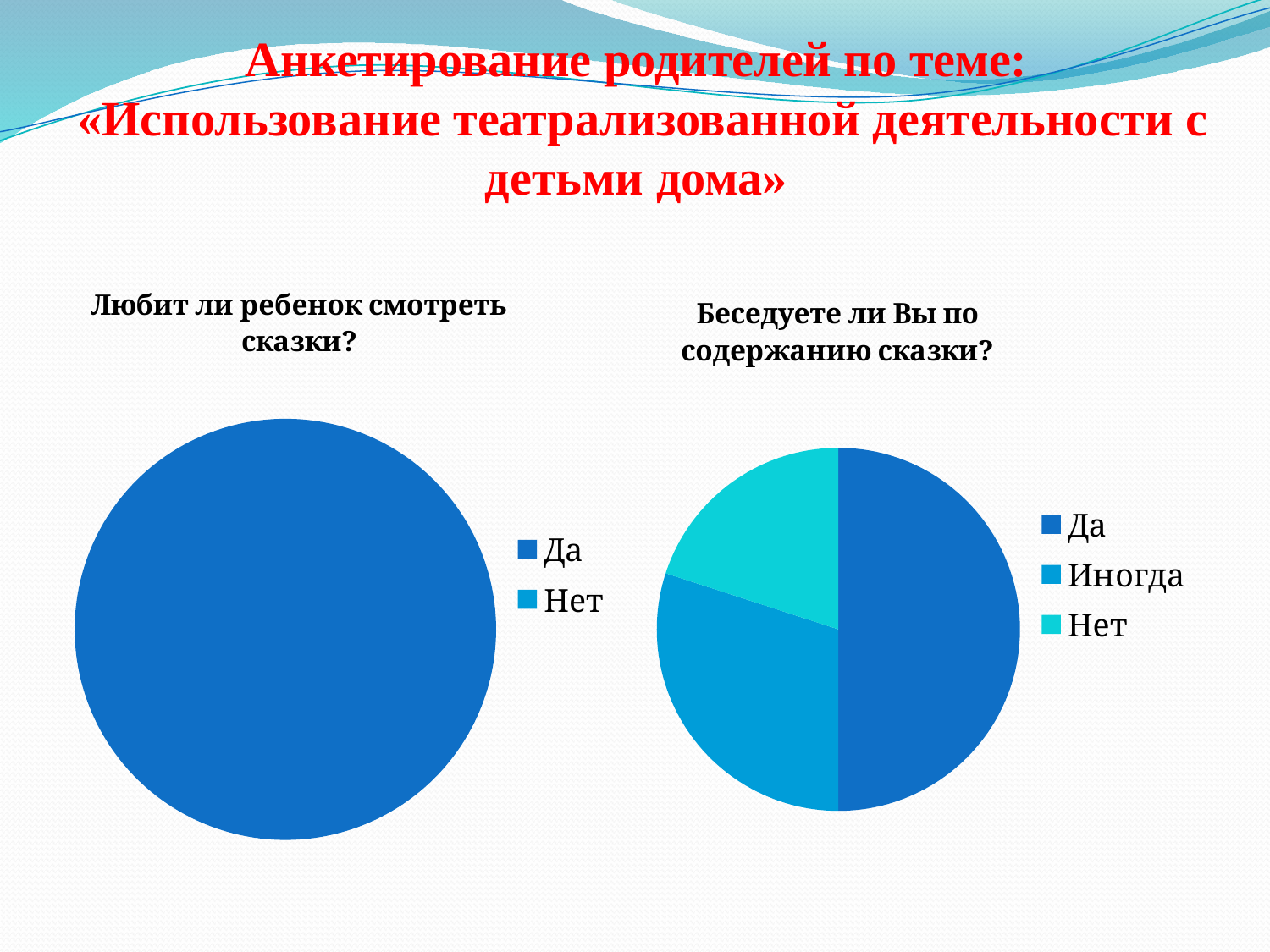
In the left chart «Любит ли ребенок смотреть сказки?», which category has the smallest slice? Нет In the right chart «Беседуете ли Вы по содержанию сказки?», how many entries does the legend list? 3 In the left chart «Любит ли ребенок смотреть сказки?», how many entries does the legend list? 2 In the right chart «Беседуете ли Вы по содержанию сказки?», which slice is larger: Да or Иногда? Да In the right chart «Беседуете ли Вы по содержанию сказки?», which category has the smallest slice? Нет What kind of chart is the right chart titled «Беседуете ли Вы по содержанию сказки?»? Pie chart What kind of chart is the left chart titled «Любит ли ребенок смотреть сказки?»? Pie chart In the right chart «Беседуете ли Вы по содержанию сказки?», which category has the largest slice? Да What is the title of the left pie chart? Любит ли ребенок смотреть сказки? In the right chart «Беседуете ли Вы по содержанию сказки?», which slice is larger: Иногда or Нет? Иногда In the right chart «Беседуете ли Вы по содержанию сказки?», which legend entry is shown in the lightest (cyan) colour? Нет In the left chart «Любит ли ребенок смотреть сказки?», which category has the largest slice? Да